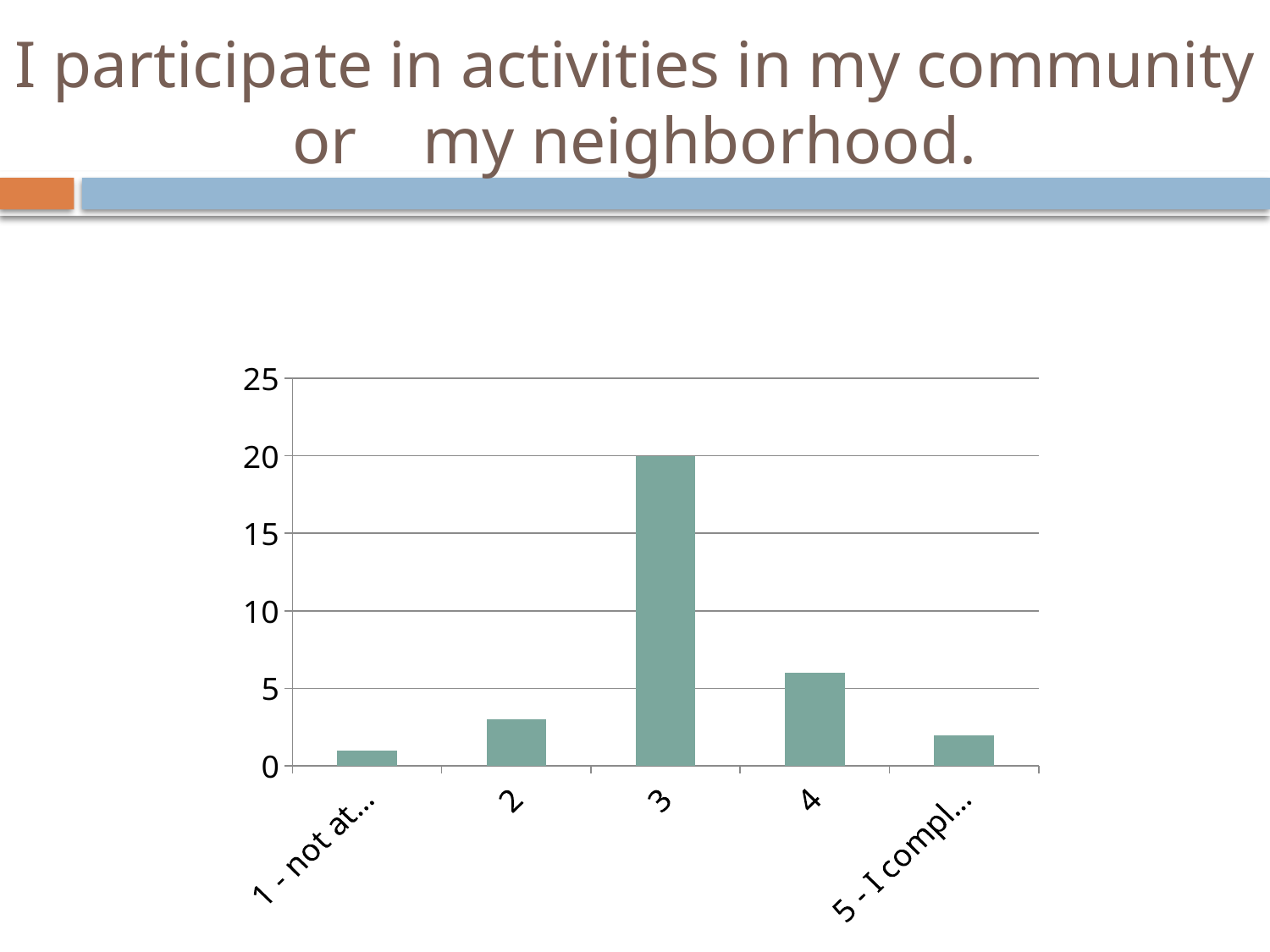
What is the title of the slide containing the chart? I participate in activities in my community or my neighborhood. Do the values rise or fall from category 3 to category 5 - I compl...? fall Is the value for category 4 greater or less than 5? greater Which category has the highest bar? 3 What kind of chart is shown on the slide? bar chart Is the value for category 3 greater or less than 15? greater Which category has the lowest bar? 1 - not at... How many categories are shown on the x axis of the chart? 5 Which is larger, the value for category 3 or the value for category 4? 3 What is the value for category 3? 20 Which is larger, the value for category 4 or the value for category 2? 4 Is the value for category 2 greater or less than 5? less